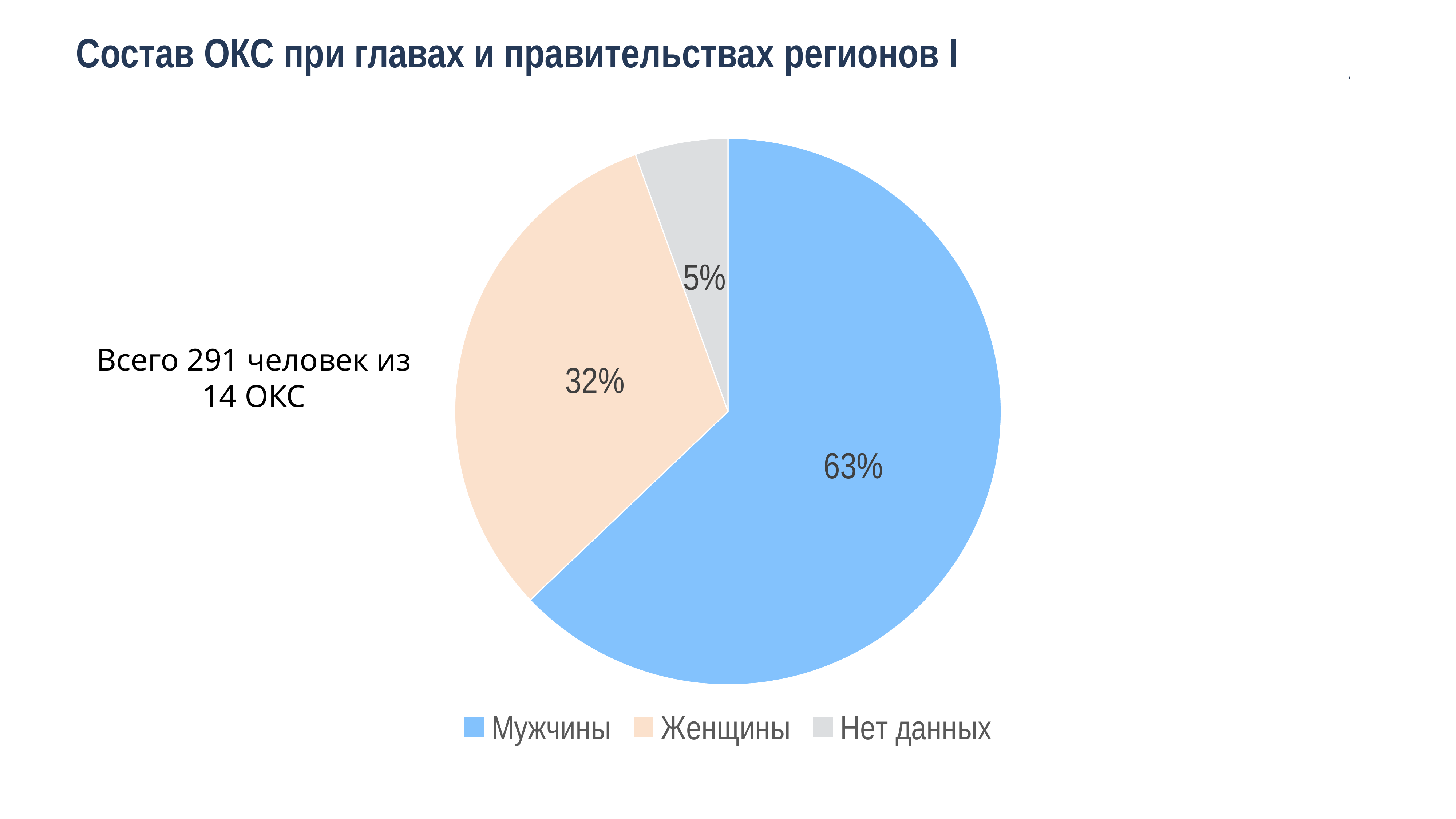
What share of the pie does Нет данных represent? 5% Which is larger, the share for Женщины or the share for Нет данных? Женщины Which colour represents Мужчины in the legend? Blue Which category has the largest slice of the pie? Мужчины What is the difference in percentage points between Женщины and Нет данных? 27 What share of the pie does Мужчины represent? 63% What kind of chart is shown on the slide? Pie chart Which category has the smallest slice of the pie? Нет данных What is the title of the slide? Состав ОКС при главах и правительствах регионов I How many slices does the pie chart have? 3 What is the difference in percentage points between Мужчины and Женщины? 31 What share of the pie does Женщины represent? 32%